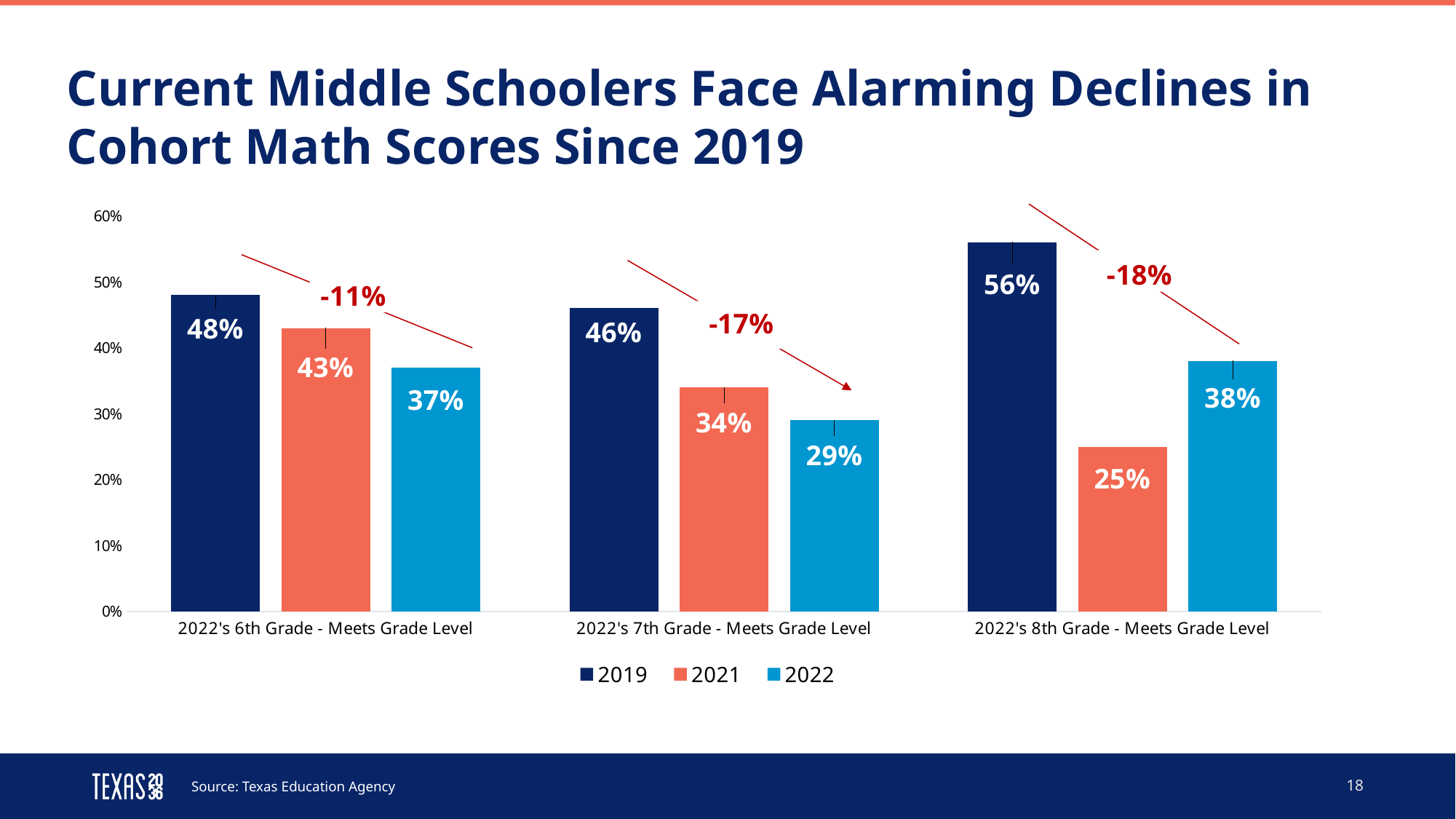
Which category has the lowest 2021 value? 2022's 8th Grade - Meets Grade Level What is the 2019 value for 2022's 6th Grade - Meets Grade Level? 48% What is the 2022 value for 2022's 8th Grade - Meets Grade Level? 38% Which category has the highest 2019 value? 2022's 8th Grade - Meets Grade Level Do the values for 2022's 7th Grade - Meets Grade Level rise or fall from 2019 to 2022? Fall How many series does the legend list? 3 Which is larger for 2022's 8th Grade - Meets Grade Level: the 2021 value or the 2022 value? 2022 What is the 2021 value for 2022's 7th Grade - Meets Grade Level? 34% What is the difference between the 2019 and 2022 values for 2022's 7th Grade - Meets Grade Level? 17% What kind of chart is shown on the slide? Bar chart What decline is annotated in red above the 2022's 6th Grade - Meets Grade Level bars? -11% How many categories are shown on the x axis? 3